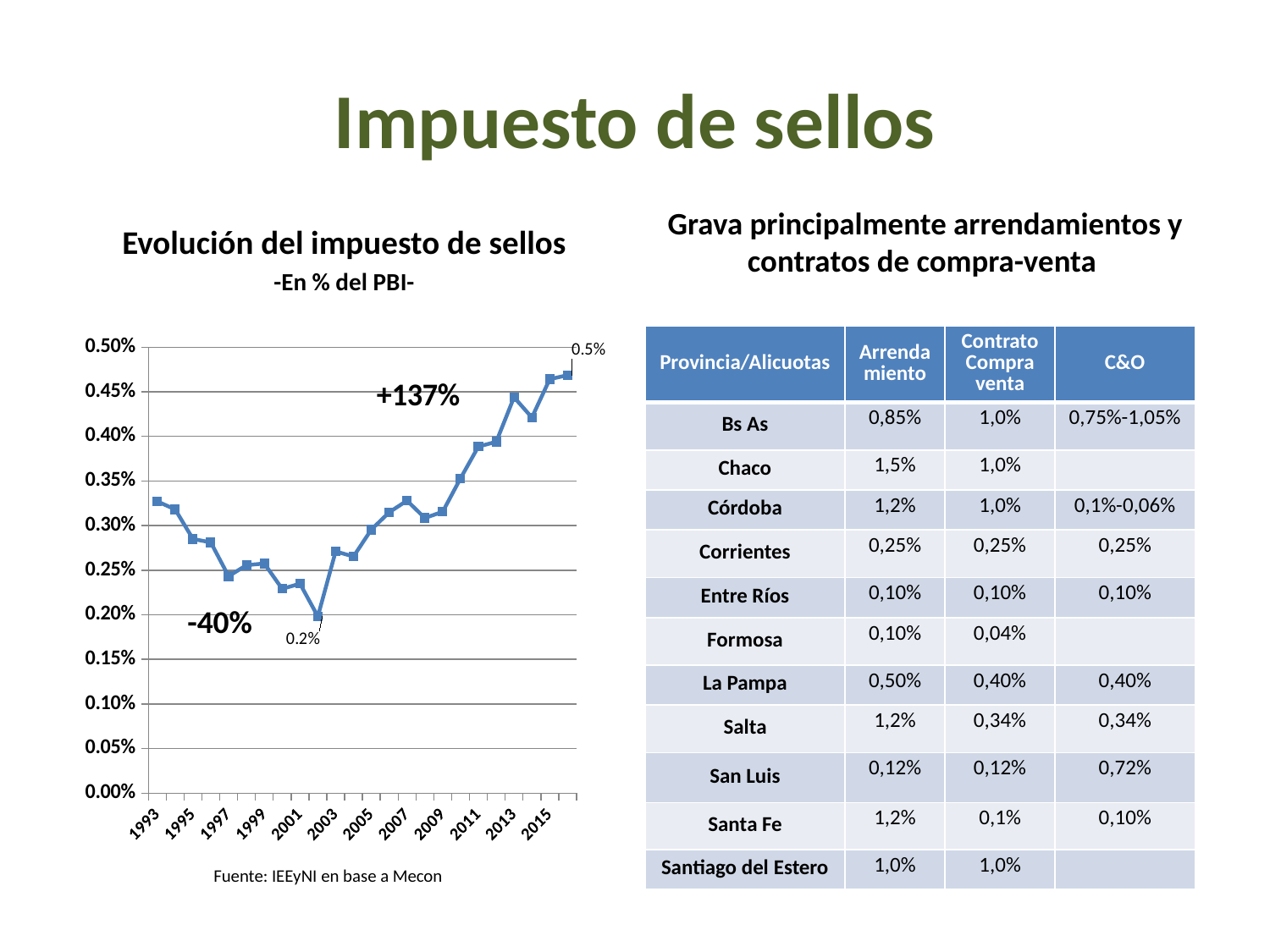
Which is larger, the value for 1993 or the value for 2013? 2013 Is the value for 1993 greater or less than 0.30%? greater What is the difference between the labelled end value (0.5%) and the labelled minimum value (0.2%)? 0.3% What kind of chart is shown on the slide? line chart What is the value printed at the last point of the line in the 'Evolución del impuesto de sellos' chart? 0.5% In which year does the line reach its lowest value? 2002 Does the line rise or fall between 1993 and 2002? fall What is the value printed at the lowest point of the line in the 'Evolución del impuesto de sellos' chart? 0.2% Is the highest value of the series at the beginning or at the end of the period? at the end What percentage change is annotated on the rising part of the line after 2002? +137% Is the value for 2001 greater or less than 0.25%? less Is the value for 2013 greater or less than 0.40%? greater